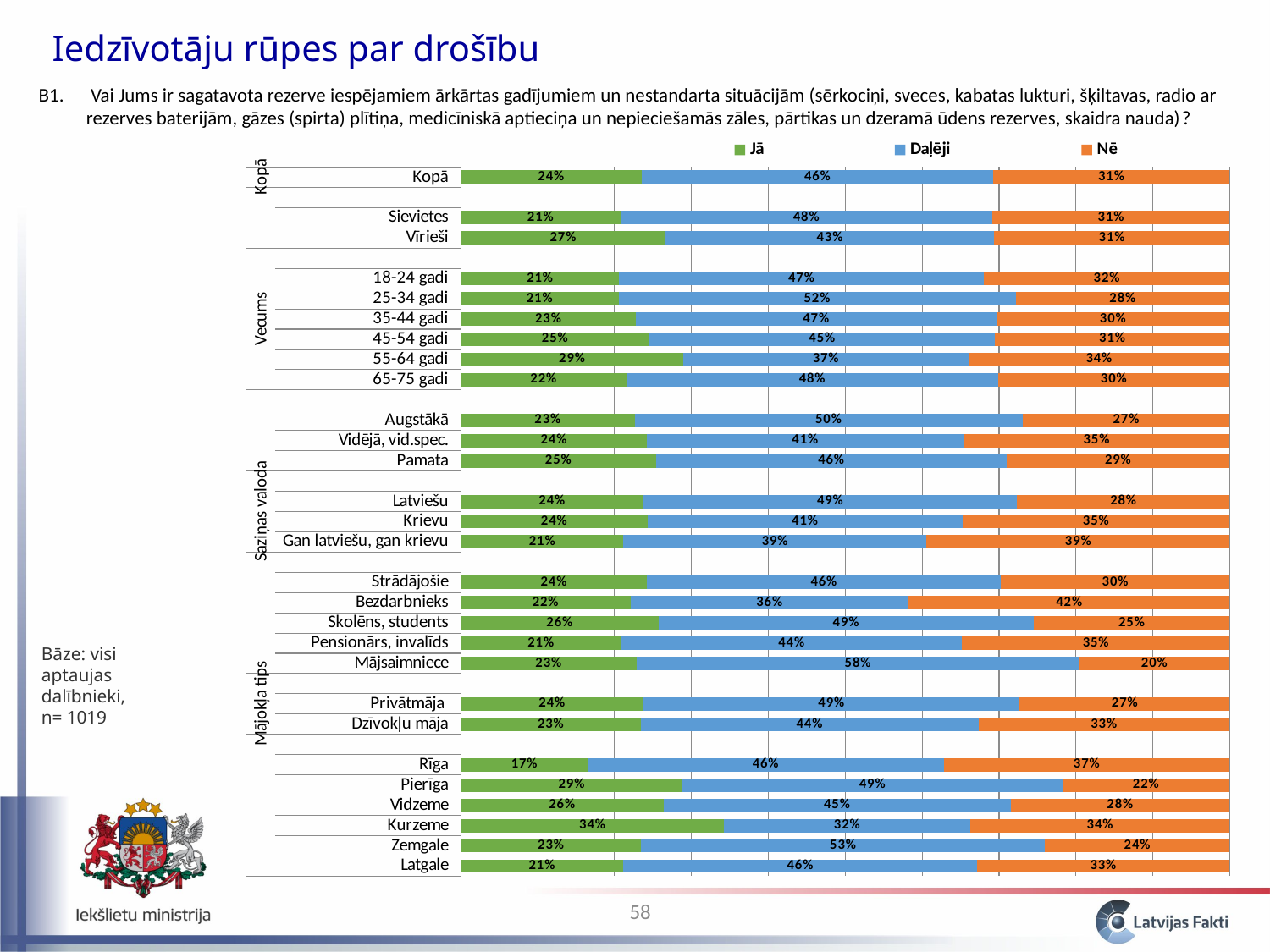
What percentage of all respondents (Kopā) answered "Jā"? 24% What is the difference in the "Nē" share between Rīga and Pierīga? 15 percentage points How many series does the legend list? 3 Which category has the highest "Jā" share? Kurzeme What kind of chart is shown on the slide? Stacked bar chart Which category has the lowest "Nē" share? Mājsaimniece What is the "Nē" value for Bezdarbnieks? 42% What is the total of the three segments for Kurzeme? 100% Which has a larger "Jā" share, Pierīga or Vidzeme? Pierīga What is the "Daļēji" value for Mājsaimniece? 58% Which category has the lowest "Jā" share? Rīga How many categories (rows) are plotted in the chart? 28